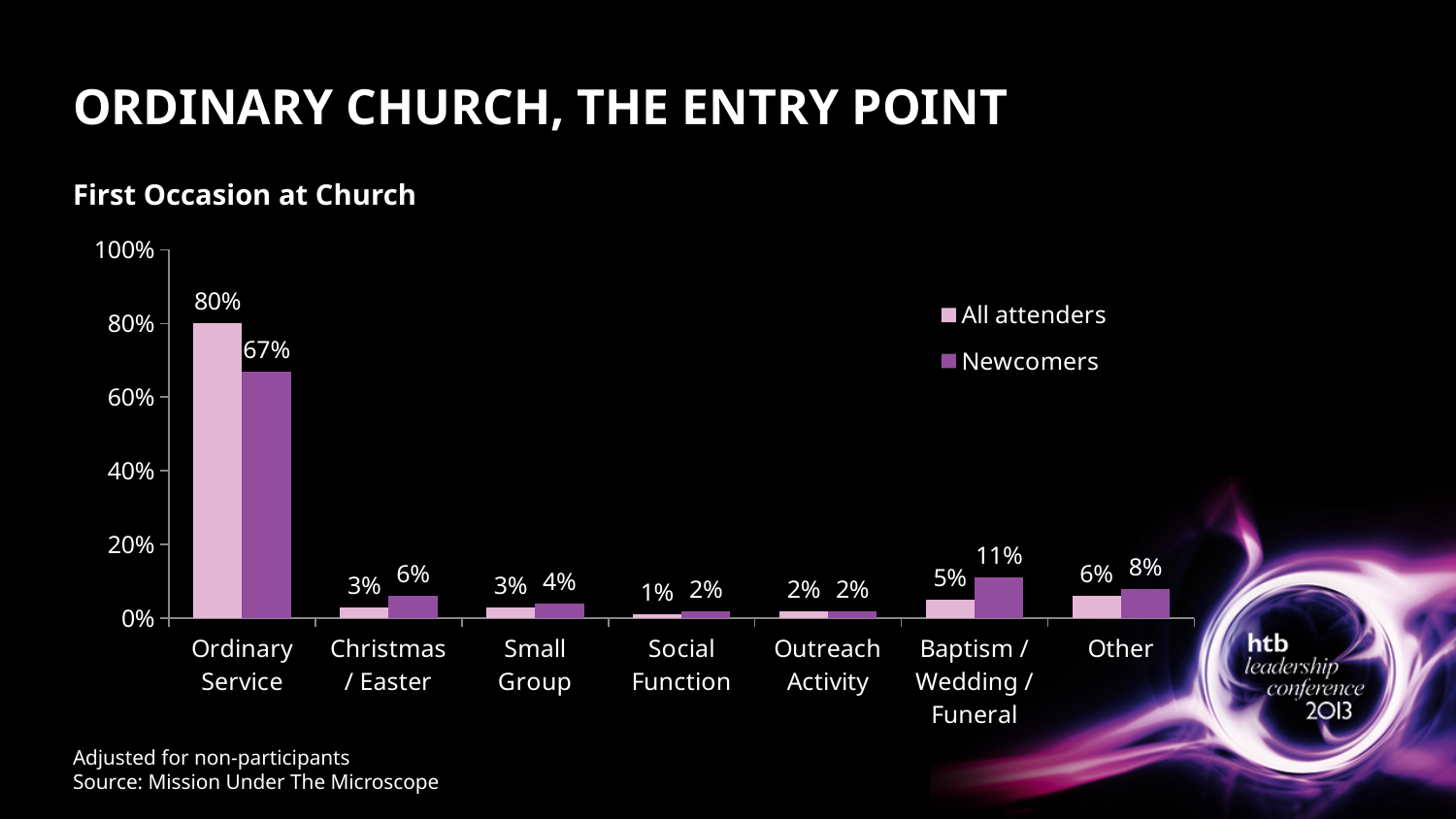
What kind of chart is shown on the slide? Bar chart Which is larger for Baptism / Wedding / Funeral: All attenders or Newcomers? Newcomers How many series does the legend list? 2 What is the title of the chart? First Occasion at Church What is the value for Newcomers for Christmas / Easter? 6% What is the difference between All attenders and Newcomers for Ordinary Service? 13% Which category has the lowest value for All attenders? Social Function How many categories are shown on the x axis? 7 Which category has the highest value for Newcomers? Ordinary Service What is the value for All attenders for Ordinary Service? 80% Is the value for Newcomers for Ordinary Service greater or less than 60%? greater What is the value for Newcomers for Baptism / Wedding / Funeral? 11%